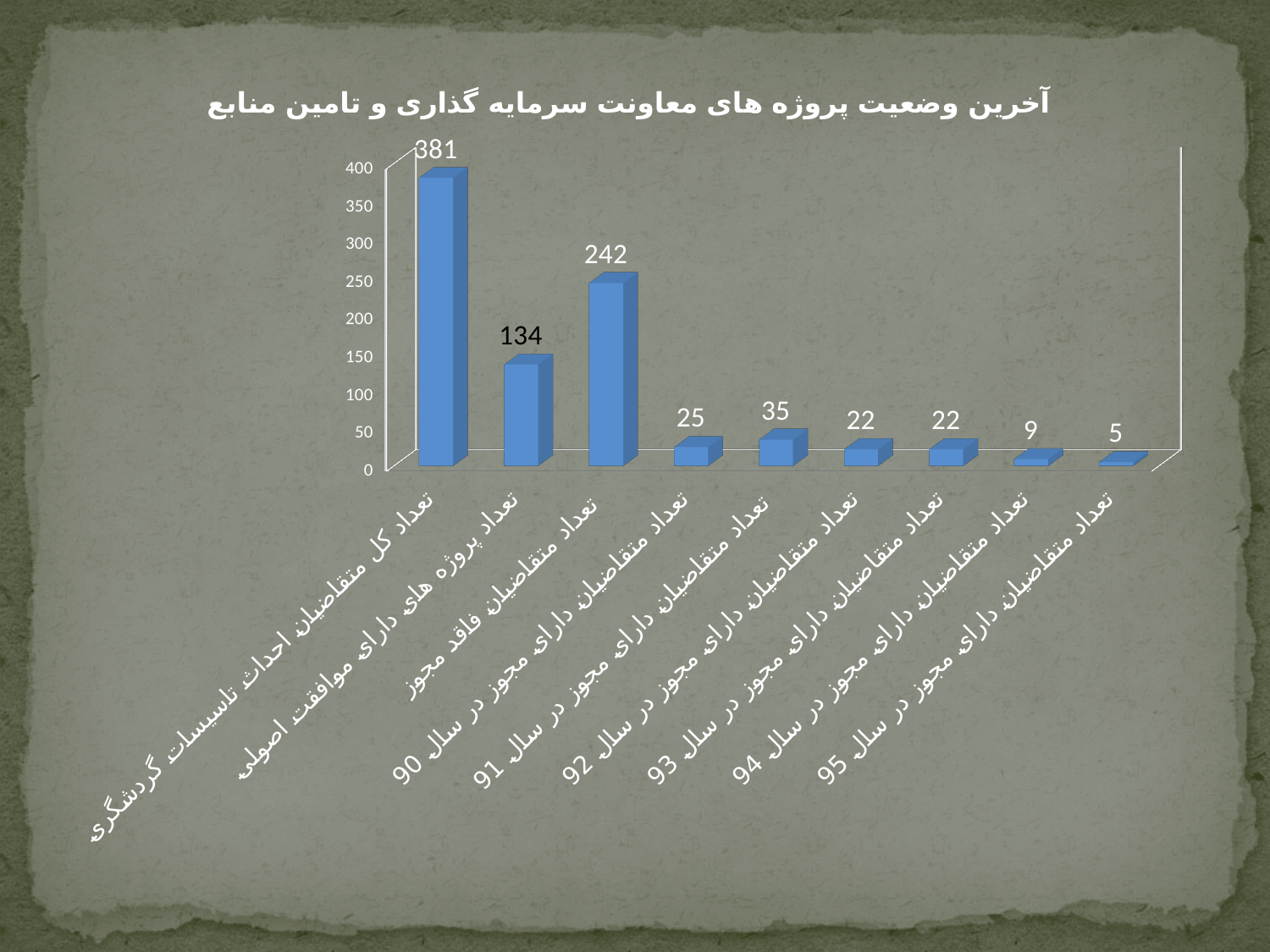
What kind of chart is shown on the slide? Bar chart Which category has the highest value? تعداد کل متقاضیان احداث تاسیسات گردشگری What is the value for "تعداد پروژه های دارای موافقت اصولی"? 134 What is the title of the chart? آخرین وضعیت پروژه های معاونت سرمایه گذاری و تامین منابع Which is larger: the value for "تعداد متقاضیان دارای مجوز در سال 90" or for "تعداد متقاضیان دارای مجوز در سال 91"? تعداد متقاضیان دارای مجوز در سال 91 What is the value for "تعداد متقاضیان فاقد مجوز"? 242 What is the value for "تعداد کل متقاضیان احداث تاسیسات گردشگری"? 381 Which category has the lowest value? تعداد متقاضیان دارای مجوز در سال 95 What is the value for "تعداد متقاضیان دارای مجوز در سال 91"? 35 What is the difference between the values for "تعداد متقاضیان فاقد مجوز" and "تعداد پروژه های دارای موافقت اصولی"? 108 How many categories are shown on the chart? 9 What is the value for "تعداد متقاضیان دارای مجوز در سال 95"? 5